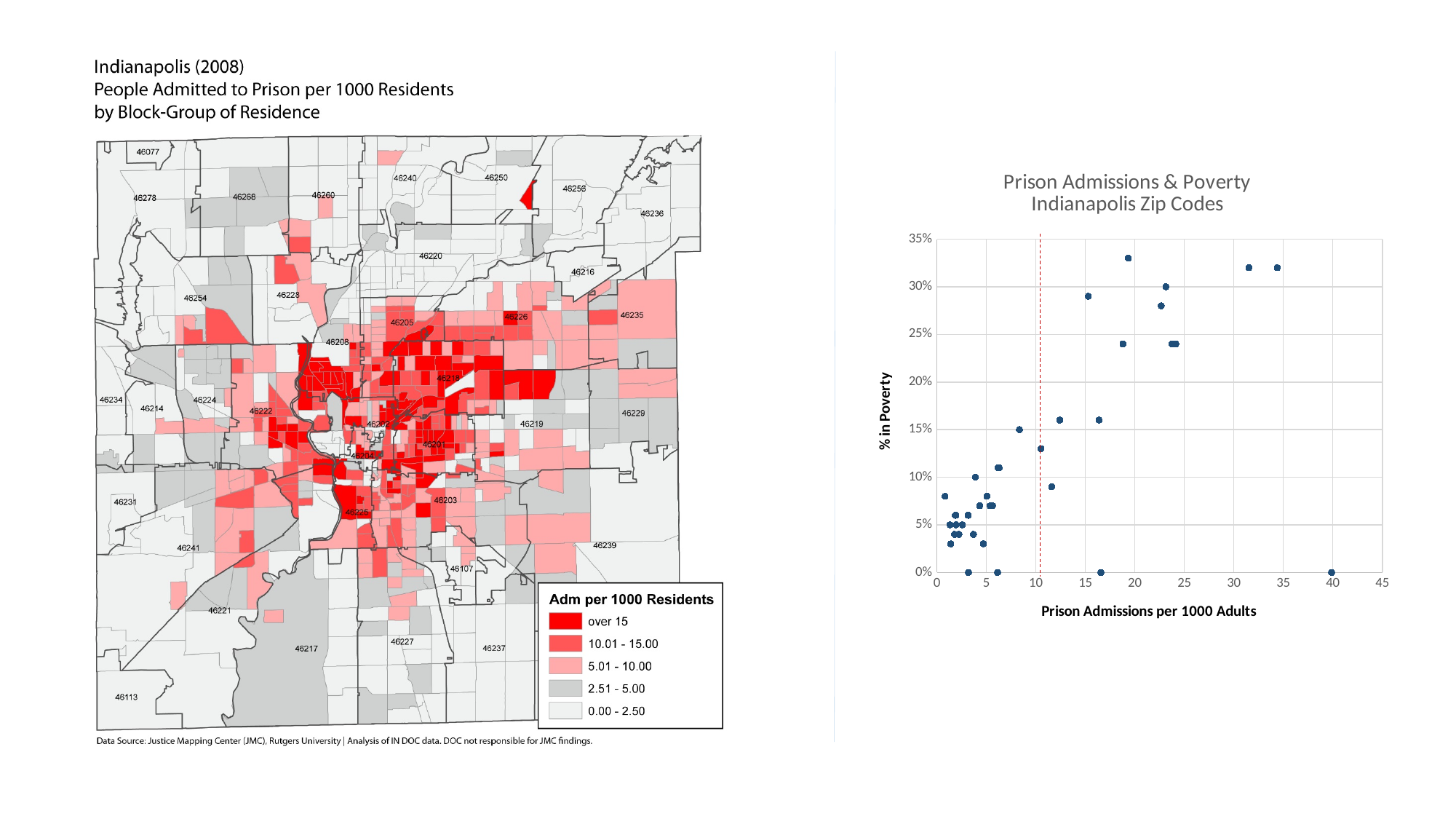
On the Indianapolis map, which legend category is shown in the darkest red? over 15 In the scatter chart on the right, what is the highest value shown on the x axis? 45 How many categories does the legend 'Adm per 1000 Residents' on the Indianapolis map list? 5 In the scatter chart on the right, as prison admissions per 1000 adults increase, does the percentage in poverty generally rise or fall? Rise In the scatter chart on the right, is the poverty percentage of the highest point greater or less than 30%? greater On the Indianapolis map, what is the lowest range in the 'Adm per 1000 Residents' legend? 0.00 - 2.50 In the scatter chart on the right, what is the label of the y axis? % in Poverty In the scatter chart on the right, is the prison admissions value of the rightmost point greater or less than 35? greater What kind of chart is the 'Prison Admissions & Poverty Indianapolis Zip Codes' chart on the right? Scatter chart In the scatter chart on the right, is the poverty percentage of the rightmost point (near 40 admissions) greater or less than 5%? less